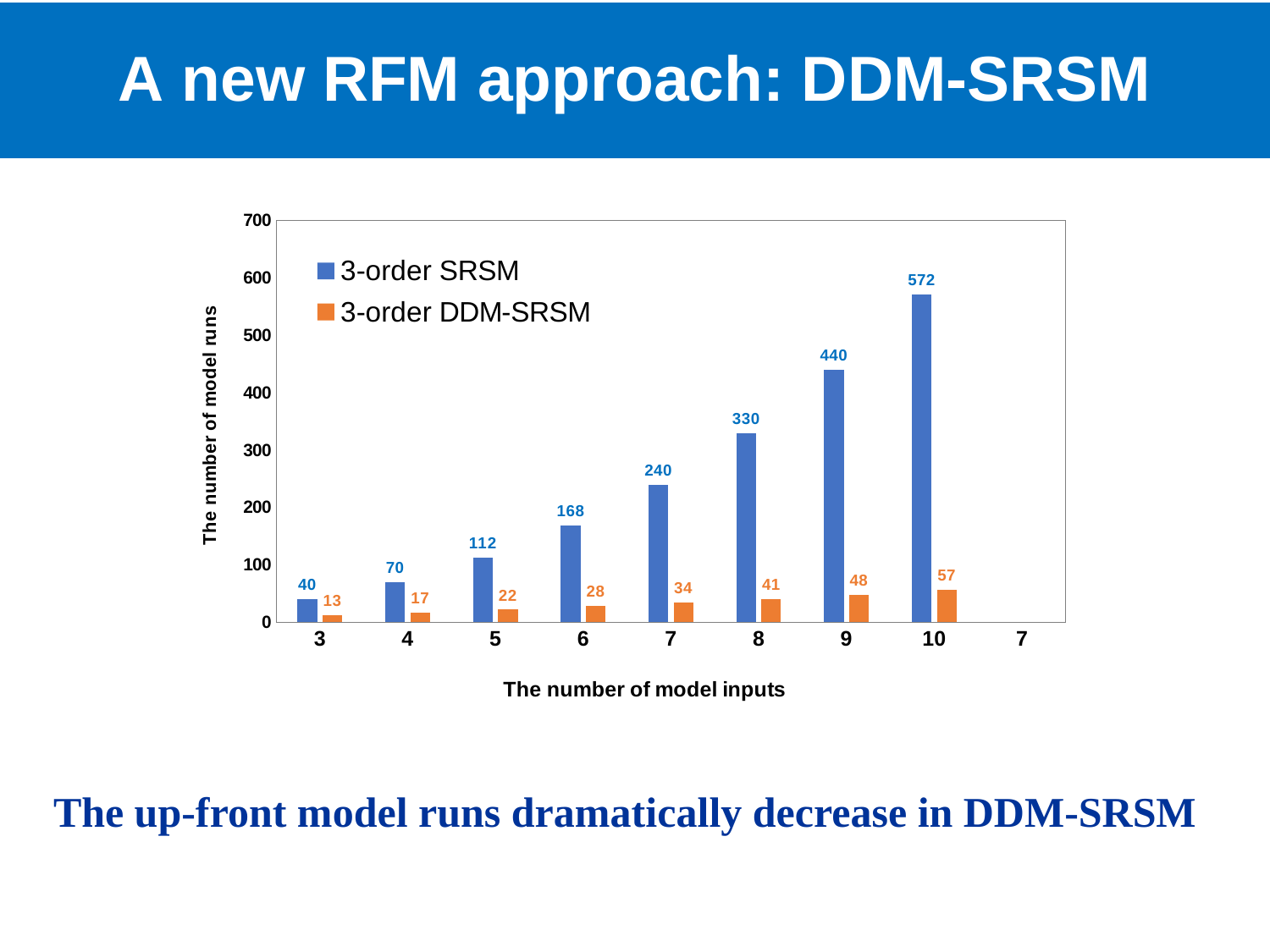
How many series does the legend list? 2 Do the 3-order SRSM values rise or fall as the number of model inputs increases from 3 to 10? Rise What is the value for 3-order DDM-SRSM when the number of model inputs is 5? 22 What is the value for 3-order SRSM when the number of model inputs is 10? 572 What is the difference between the 3-order SRSM and 3-order DDM-SRSM values when the number of model inputs is 7? 206 What is the label of the y axis? The number of model runs What is the value for 3-order DDM-SRSM when the number of model inputs is 9? 48 At which number of model inputs is the 3-order DDM-SRSM value lowest? 3 What kind of chart is shown on the slide? Bar chart Which is larger: the 3-order SRSM value at 4 model inputs or the 3-order DDM-SRSM value at 10 model inputs? 3-order SRSM at 4 model inputs At which number of model inputs is the 3-order SRSM value highest? 10 What is the value for 3-order SRSM when the number of model inputs is 8? 330